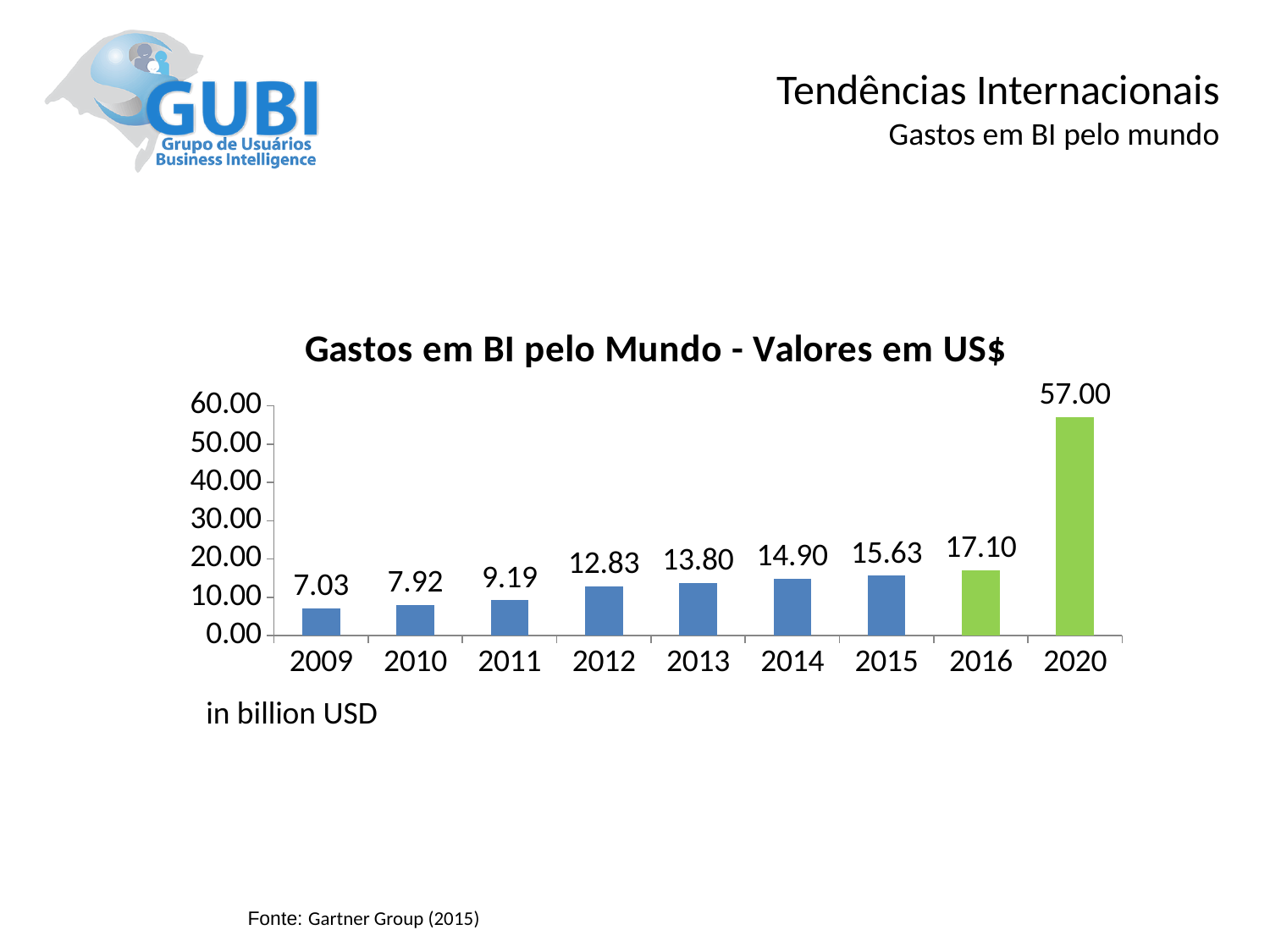
What is the difference between the values for 2020 and 2016? 39.90 What is the value for 2020? 57.00 What is the difference between the values for 2015 and 2014? 0.73 Which is larger, the value for 2012 or the value for 2011? 2012 Which year has the lowest value? 2009 What kind of chart is this? bar chart Is the value for 2020 greater or less than 50.00? greater What is the value for 2009? 7.03 Which year has the highest value? 2020 What is the value for 2013? 13.80 What is the title of the chart? Gastos em BI pelo Mundo - Valores em US$ How many years are shown on the x axis? 9